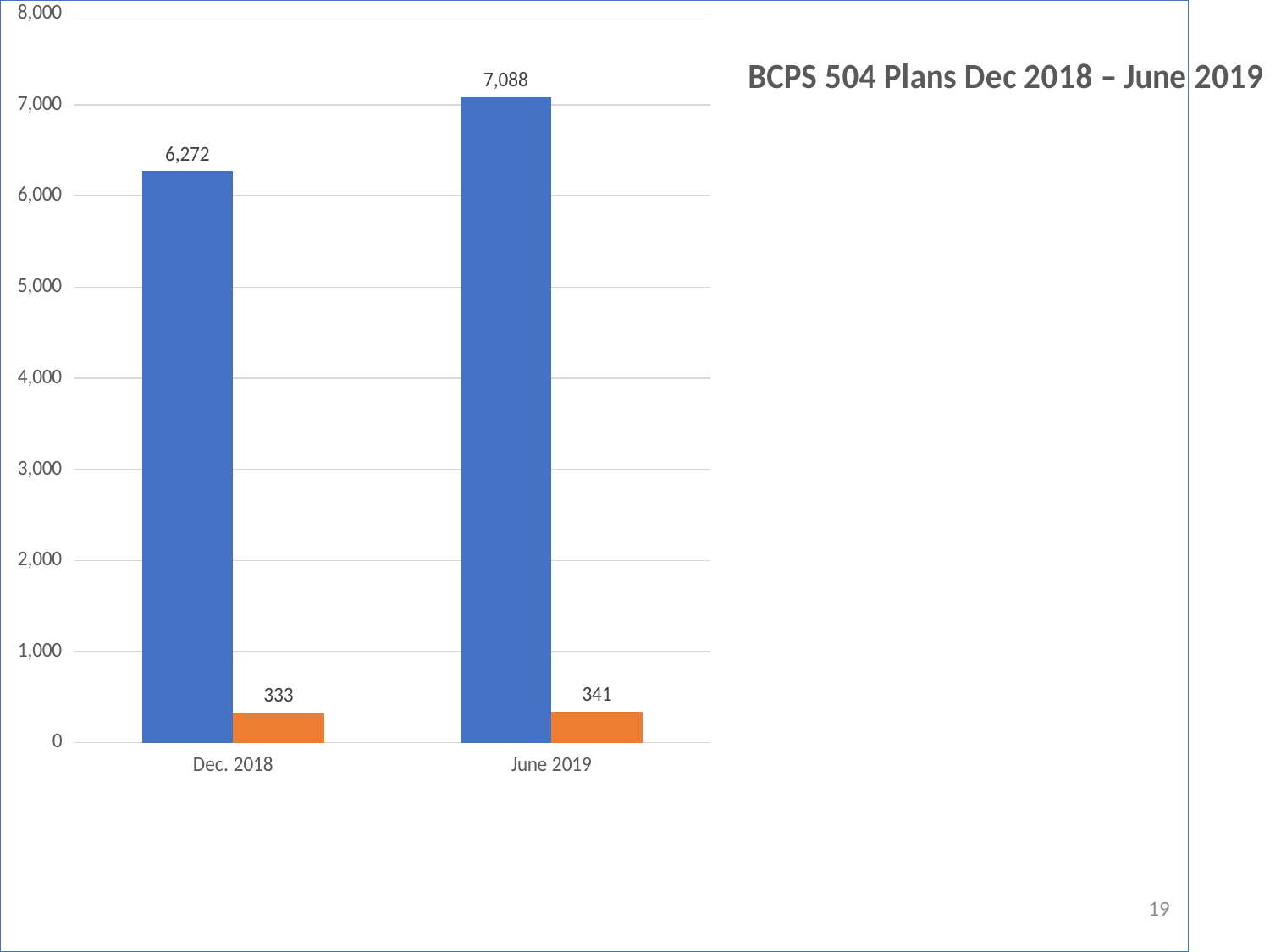
How many categories are shown on the x axis? 2 What is the title shown on the slide? BCPS 504 Plans Dec 2018 – June 2019 Which category has the taller blue bar, Dec. 2018 or June 2019? June 2019 What is the difference between the orange bar values for June 2019 and Dec. 2018? 8 What kind of chart is shown on the slide? Bar chart By how much did the blue bar increase from Dec. 2018 to June 2019? 816 What is the value of the orange bar for Dec. 2018? 333 What is the value of the orange bar for June 2019? 341 Do the blue bar values rise or fall from Dec. 2018 to June 2019? Rise Is the value of the blue bar for Dec. 2018 greater or less than 6,000? greater What is the value of the blue bar for Dec. 2018? 6,272 What is the value of the blue bar for June 2019? 7,088